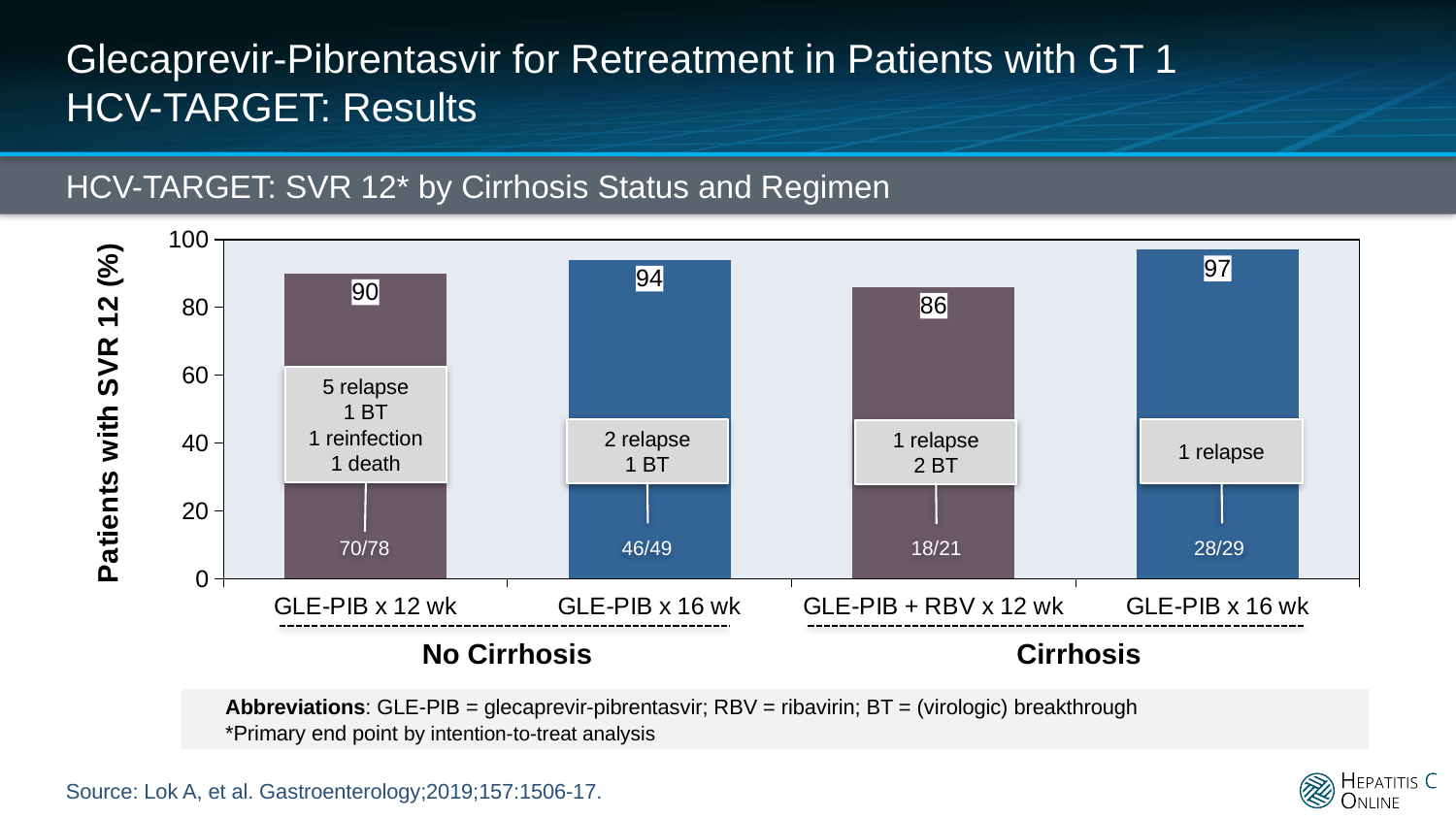
Which has a higher SVR 12 rate: GLE-PIB x 12 wk in the No Cirrhosis group or GLE-PIB + RBV x 12 wk in the Cirrhosis group? GLE-PIB x 12 wk, No Cirrhosis Which regimen and group has the lowest SVR 12 rate? GLE-PIB + RBV x 12 wk, Cirrhosis How many patients were treated with GLE-PIB + RBV x 12 wk in the Cirrhosis group, according to the fraction shown on the bar? 21 What is the difference in SVR 12 rate between GLE-PIB x 16 wk and GLE-PIB x 12 wk in the No Cirrhosis group? 4 What is the SVR 12 rate for GLE-PIB + RBV x 12 wk in the Cirrhosis group? 86 What is the y-axis label of the chart? Patients with SVR 12 (%) What type of chart is shown on the slide? Bar chart What is the SVR 12 rate for GLE-PIB x 16 wk in the Cirrhosis group? 97 What is the SVR 12 rate for GLE-PIB x 12 wk in the No Cirrhosis group? 90 Which regimen and group has the highest SVR 12 rate? GLE-PIB x 16 wk, Cirrhosis What fraction of patients achieved SVR 12 with GLE-PIB x 16 wk in the No Cirrhosis group? 46/49 How many bars are shown in the chart? 4